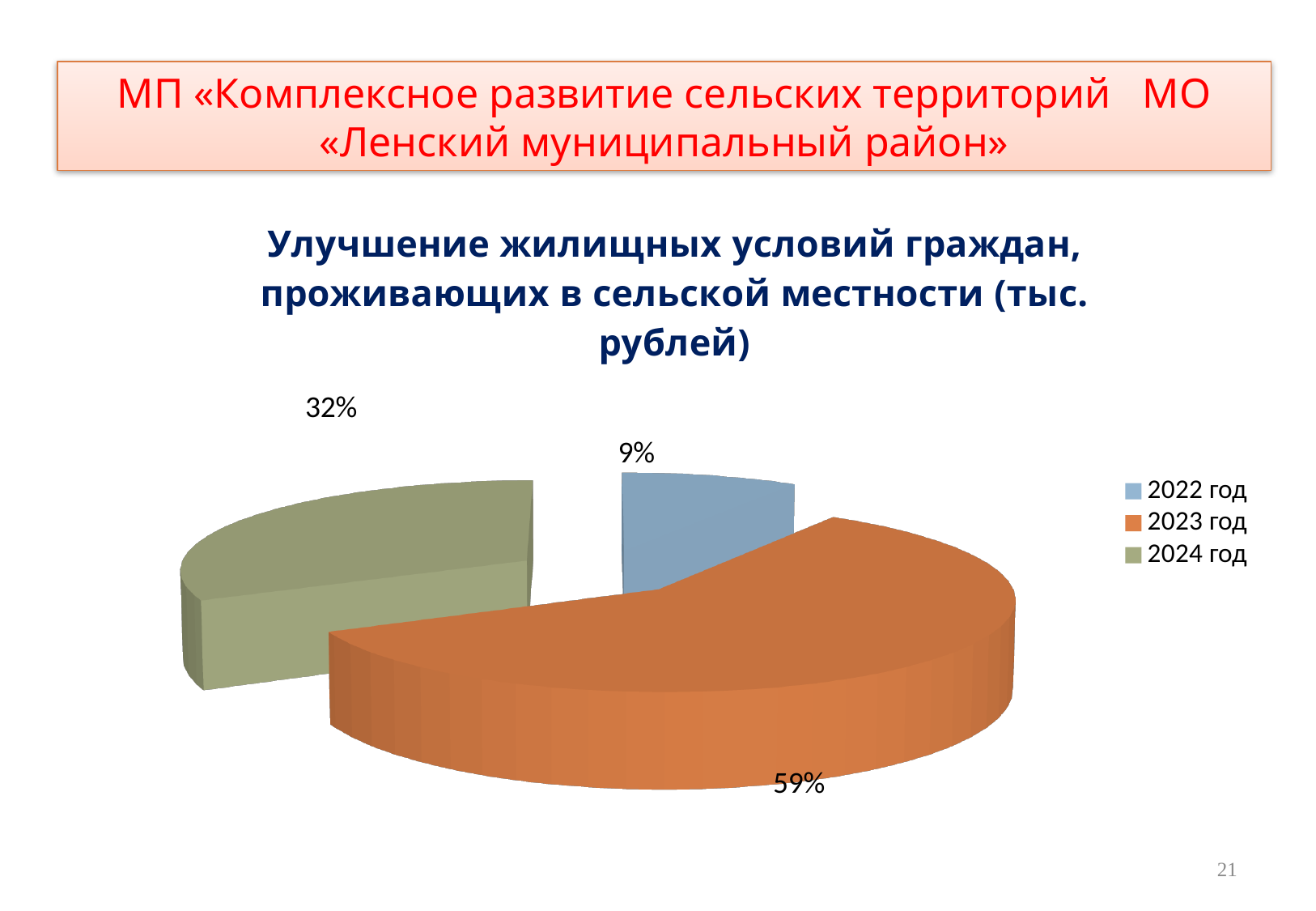
What share of the pie does 2024 год take? 32% Which year has the largest slice of the pie? 2023 год How many entries does the legend list? 3 Which is larger, the share for 2024 год or the share for 2022 год? 2024 год What colour is the slice for 2024 год? green What kind of chart is shown on the slide? pie chart By how many percentage points does the 2024 год share exceed the 2022 год share? 23 What share of the pie does 2022 год take? 9% How many slices does the pie chart have? 3 What share of the pie does 2023 год take? 59% Which year has the smallest slice of the pie? 2022 год By how many percentage points does the 2023 год share exceed the 2024 год share? 27